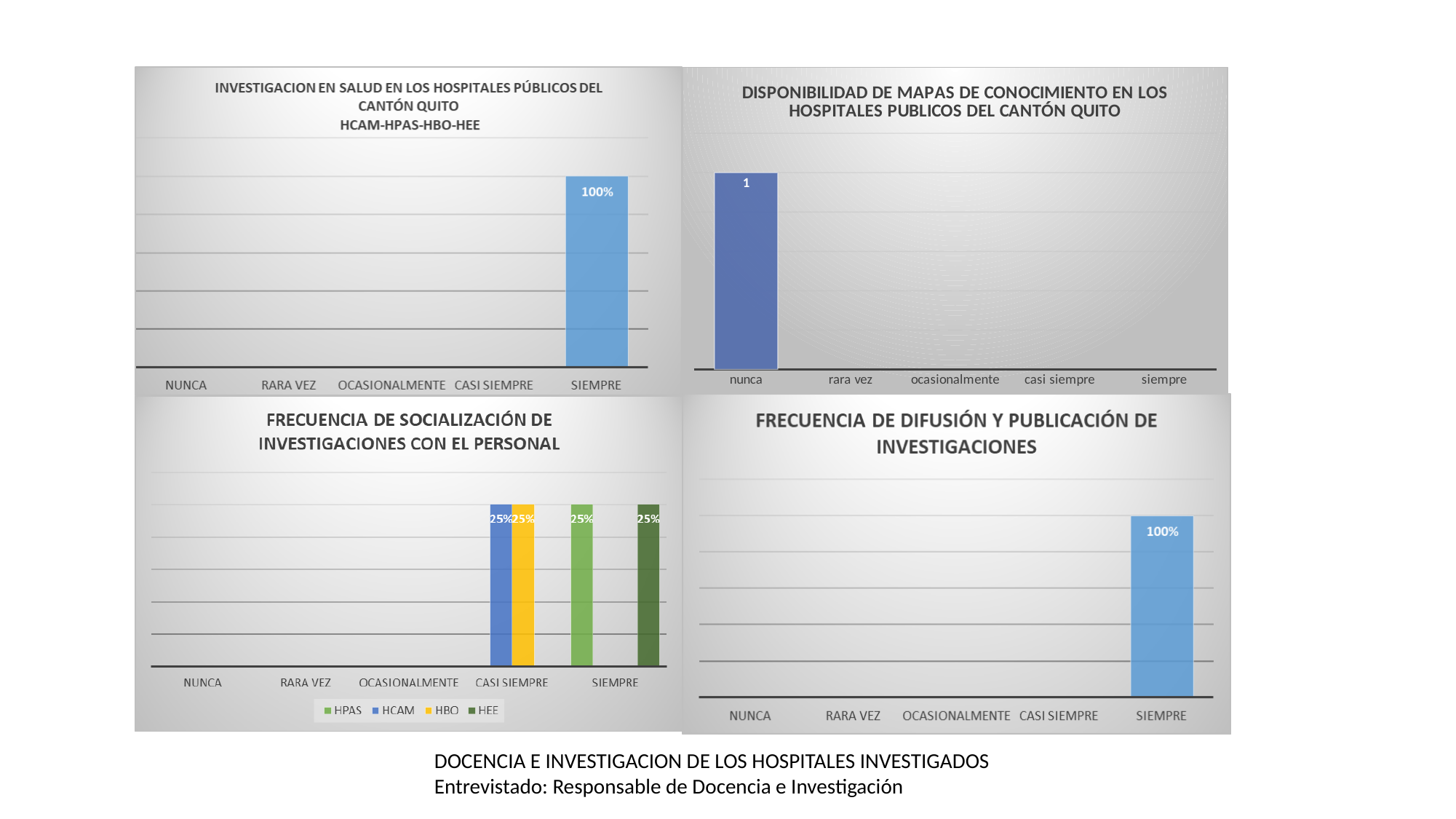
How many categories are shown on the x axis of the top-left chart (INVESTIGACION EN SALUD EN LOS HOSPITALES PÚBLICOS DEL CANTÓN QUITO)? 5 In the bottom-left chart (FRECUENCIA DE SOCIALIZACIÓN DE INVESTIGACIONES CON EL PERSONAL), what is the value for HCAM at CASI SIEMPRE? 25% In the top-right chart (DISPONIBILIDAD DE MAPAS DE CONOCIMIENTO), what value is labelled on the bar for nunca? 1 What kind of chart is the top-right chart (DISPONIBILIDAD DE MAPAS DE CONOCIMIENTO)? Bar chart In the bottom-right chart (FRECUENCIA DE DIFUSIÓN Y PUBLICACIÓN DE INVESTIGACIONES), what is the value shown for SIEMPRE? 100% In the bottom-right chart (FRECUENCIA DE DIFUSIÓN Y PUBLICACIÓN DE INVESTIGACIONES), which category has the highest value? SIEMPRE In the top-left chart (INVESTIGACION EN SALUD EN LOS HOSPITALES PÚBLICOS DEL CANTÓN QUITO), which category has the highest value? SIEMPRE In the top-left chart (INVESTIGACION EN SALUD EN LOS HOSPITALES PÚBLICOS DEL CANTÓN QUITO), what is the value shown for SIEMPRE? 100% In the top-right chart (DISPONIBILIDAD DE MAPAS DE CONOCIMIENTO), which category has the highest value? nunca In the bottom-left chart (FRECUENCIA DE SOCIALIZACIÓN DE INVESTIGACIONES CON EL PERSONAL), which series are listed in the legend? HPAS, HCAM, HBO, HEE In the bottom-left chart (FRECUENCIA DE SOCIALIZACIÓN DE INVESTIGACIONES CON EL PERSONAL), what is the value for HEE at SIEMPRE? 25% How many series does the legend list in the bottom-left chart (FRECUENCIA DE SOCIALIZACIÓN DE INVESTIGACIONES CON EL PERSONAL)? 4